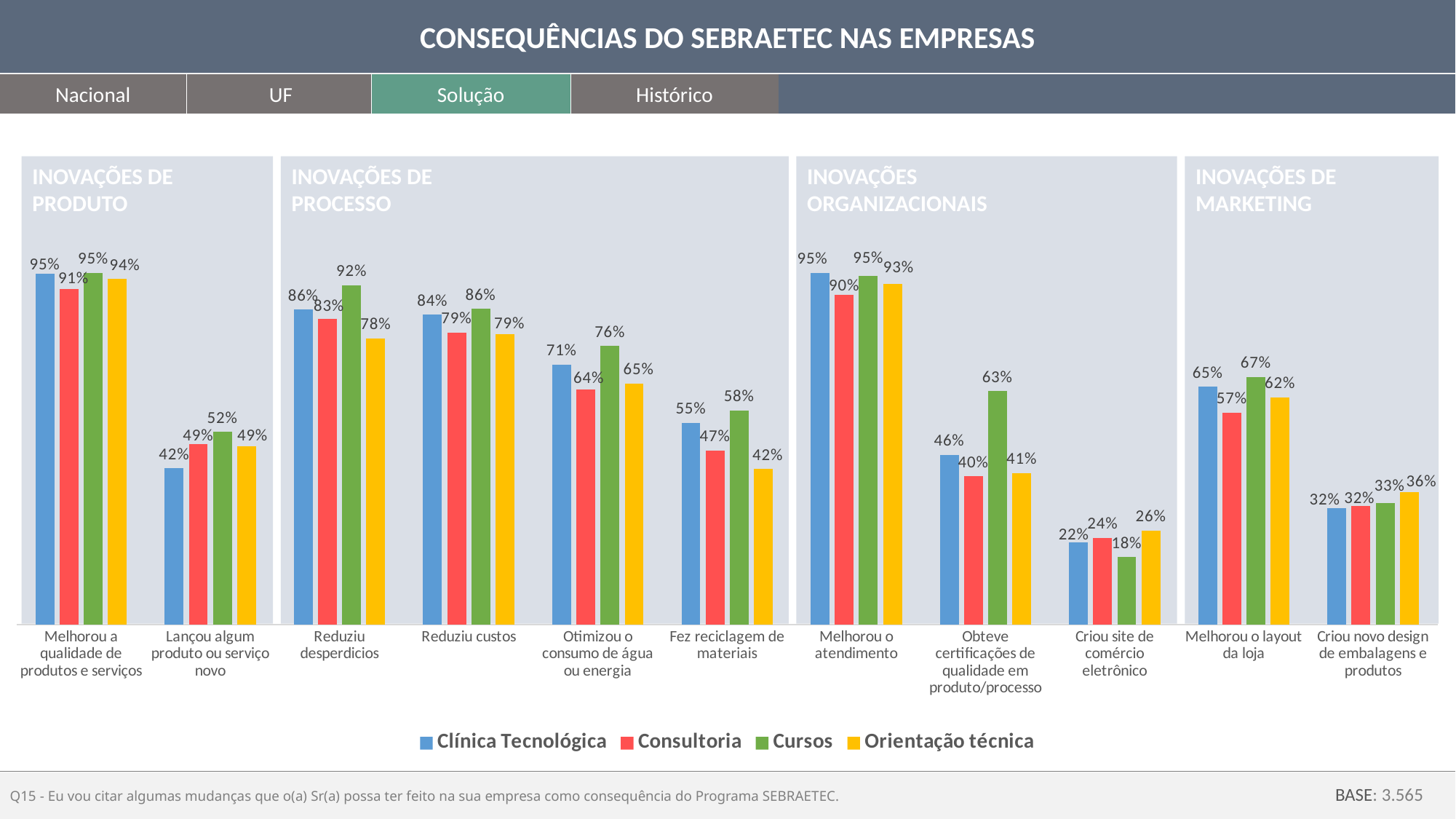
What is the value for Clínica Tecnológica in the category 'Otimizou o consumo de água ou energia'? 71% What is the difference between the Cursos and Consultoria values in the category 'Obteve certificações de qualidade em produto/processo'? 23% Which is larger in the category 'Fez reciclagem de materiais': the Clínica Tecnológica value or the Orientação técnica value? Clínica Tecnológica Which colour represents the Consultoria series in the chart? Red What is the value for Consultoria in the category 'Criou site de comércio eletrônico'? 24% How many series does the legend list? 4 What is the value for Orientação técnica in the category 'Melhorou o layout da loja'? 62% What is the value for Cursos in the category 'Reduziu desperdicios'? 92% How many categories are shown along the x axis of the chart? 11 Which series has the highest value in the category 'Obteve certificações de qualidade em produto/processo'? Cursos Which series has the lowest value in the category 'Criou site de comércio eletrônico'? Cursos What kind of chart is shown on the slide? Bar chart